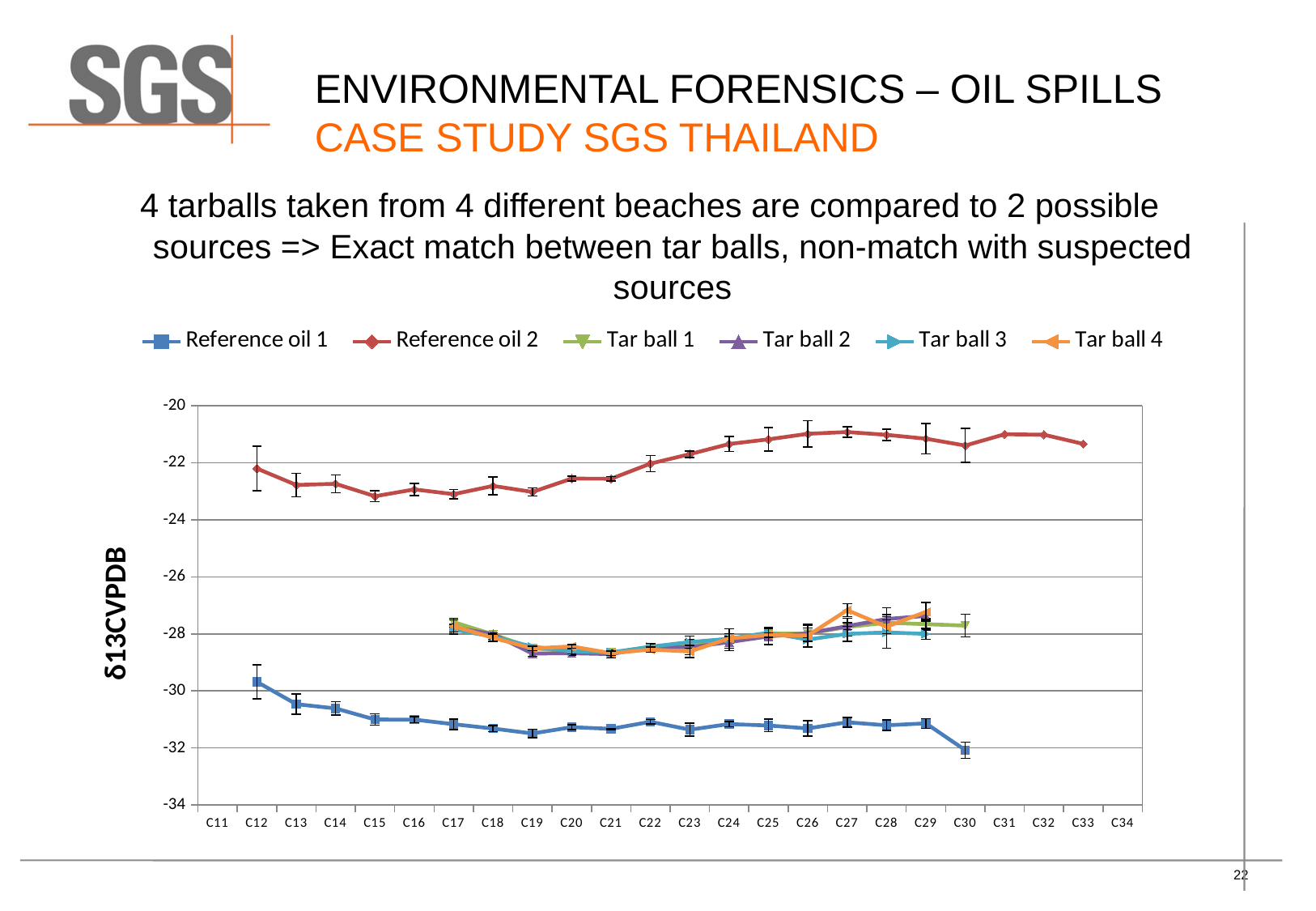
How many categories are labelled along the x axis? 24 Is the value for Reference oil 1 at C19 greater or less than -30? less Is the value for Tar ball 1 at C21 greater or less than -28? less Is the value for Reference oil 2 at C27 greater or less than -22? greater What is the label on the y axis? δ13CVPDB Which series has the highest values on the chart? Reference oil 2 How many series does the legend list? 6 At C20, which is higher: Reference oil 2 or Reference oil 1? Reference oil 2 What kind of chart is shown on the slide? line chart Does the Reference oil 2 line rise or fall from C19 to C27? rise Which series has the lowest values on the chart? Reference oil 1